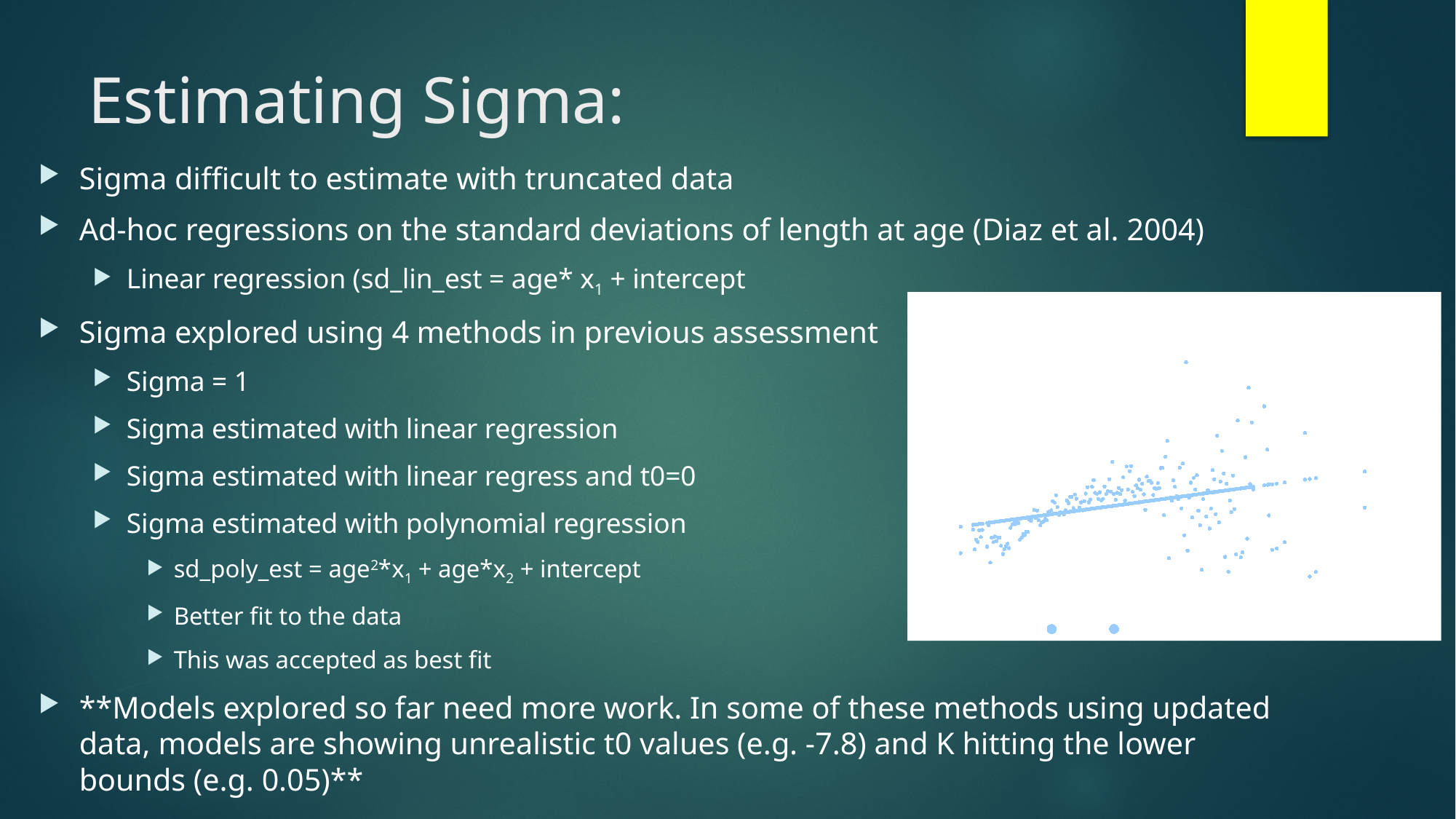
Does the fitted line in the scatter chart rise or fall from left to right? rise What colour are the points plotted in the scatter chart? light blue What kind of chart is shown on the right side of the slide? scatter chart